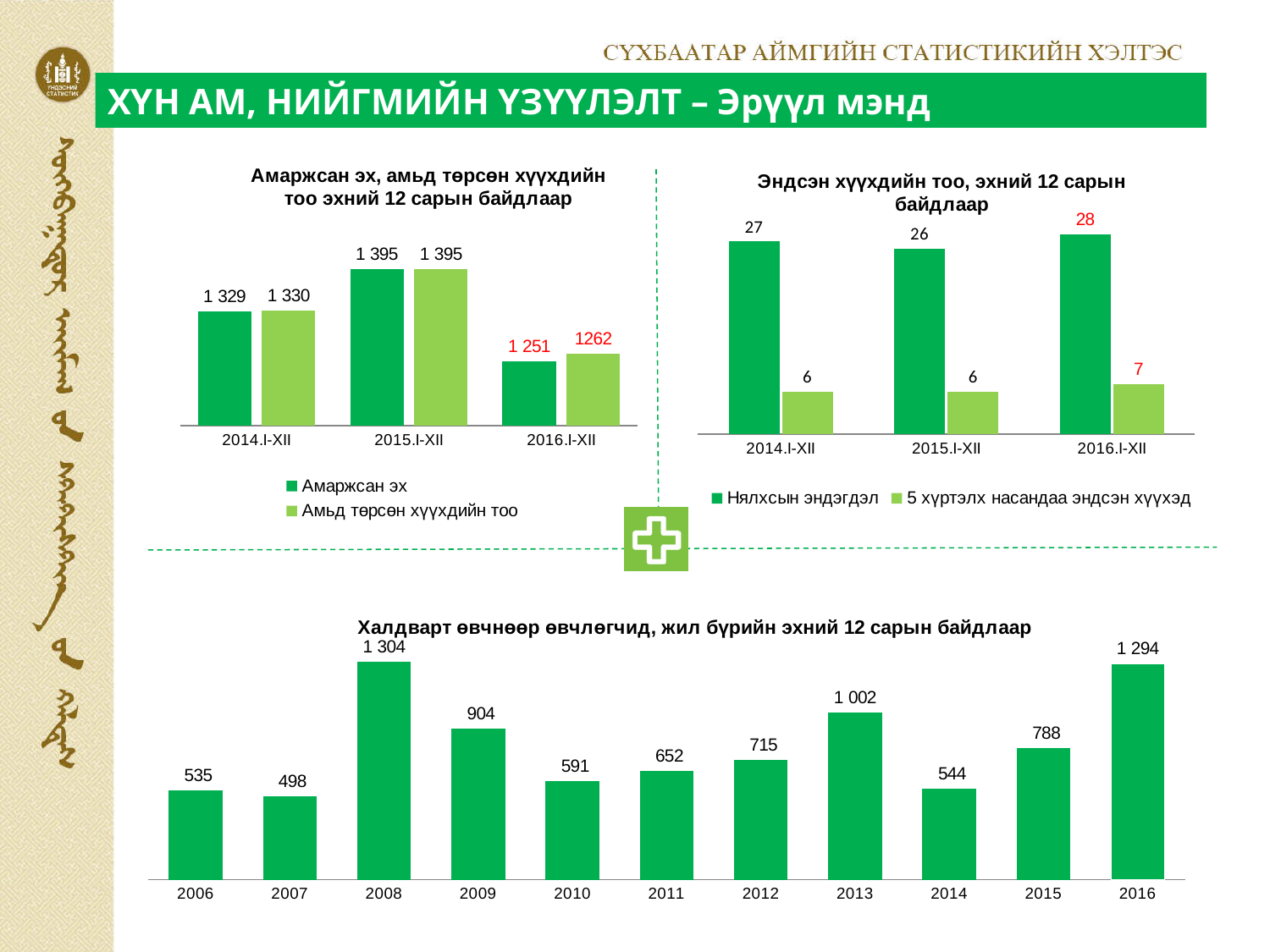
How many series does the legend of the top-left chart (Амаржсан эх, амьд төрсөн хүүхдийн тоо) list? 2 In the top-right chart (Эндсэн хүүхдийн тоо), what is the difference between Нялхсын эндэгдэл and 5 хүртэлх насандаа эндсэн хүүхэд in 2014.I-XII? 21 In the bottom chart (Халдварт өвчнөөр өвчлөгчид), which year has the lowest value? 2007 How many years are shown in the bottom chart (Халдварт өвчнөөр өвчлөгчид)? 11 In the bottom chart (Халдварт өвчнөөр өвчлөгчид), what is the value for 2013? 1 002 What type of chart is the bottom chart (Халдварт өвчнөөр өвчлөгчид)? Bar chart In the bottom chart (Халдварт өвчнөөр өвчлөгчид), which year has the highest value? 2008 In the top-left chart (Амаржсан эх, амьд төрсөн хүүхдийн тоо), what is the value for Амаржсан эх in 2015.I-XII? 1 395 In the top-right chart (Эндсэн хүүхдийн тоо), what is the value for Нялхсын эндэгдэл in 2016.I-XII? 28 In the top-right chart (Эндсэн хүүхдийн тоо), which period has the lowest value for Нялхсын эндэгдэл? 2015.I-XII In the top-left chart (Амаржсан эх, амьд төрсөн хүүхдийн тоо), what is the difference between Амьд төрсөн хүүхдийн тоо and Амаржсан эх in 2014.I-XII? 1 In the top-left chart (Амаржсан эх, амьд төрсөн хүүхдийн тоо), what is the value for Амьд төрсөн хүүхдийн тоо in 2016.I-XII? 1262